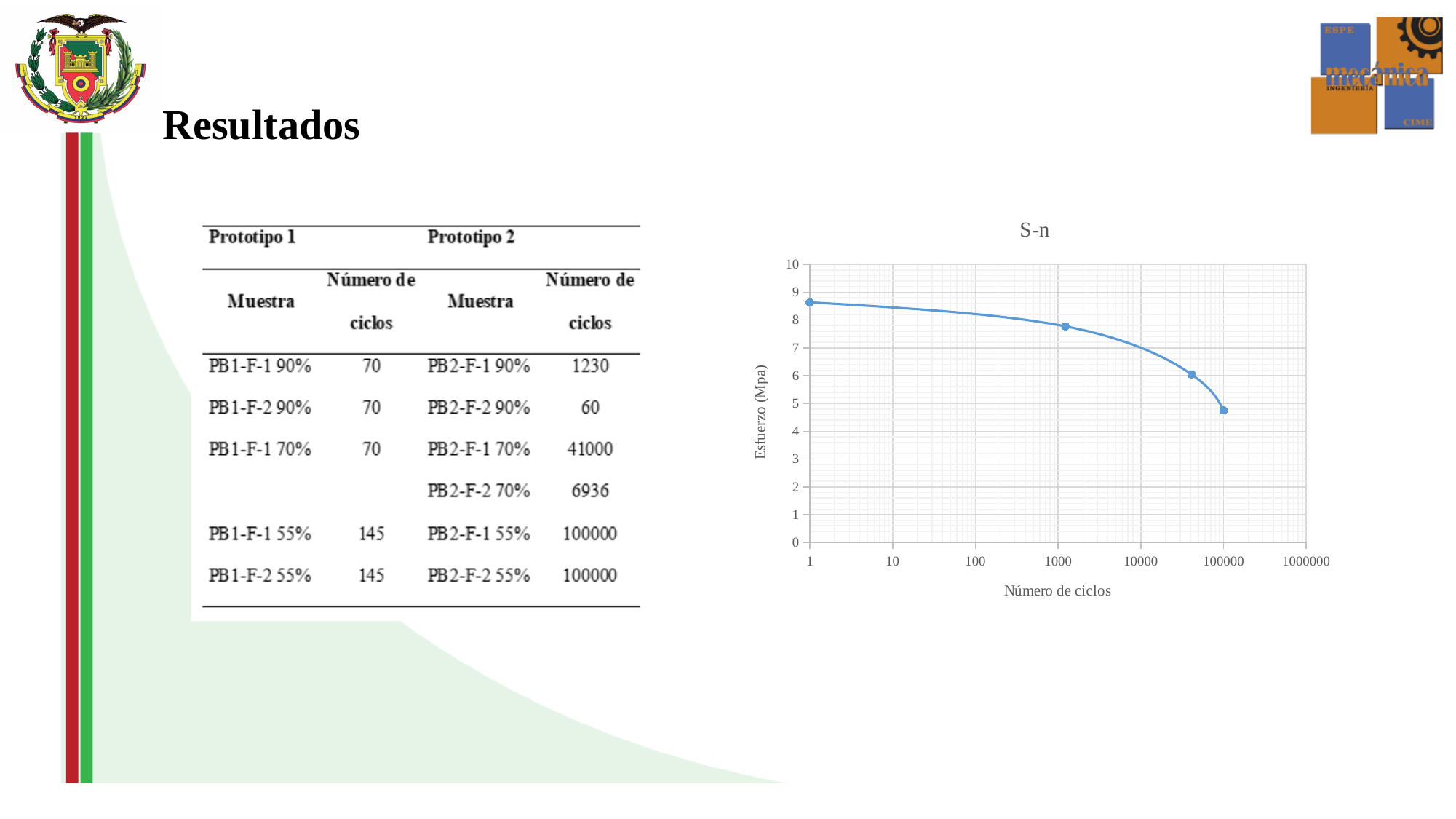
On the S-n chart, which has the higher stress: the point at 1 cycle or the point at 100000 cycles? the point at 1 cycle On the S-n chart, is the stress at the second data point (around 1000 cycles) greater or less than 7 Mpa? greater On the S-n chart, is the stress at 1 cycle greater or less than 8 Mpa? greater On the S-n chart, is the stress at the third data point (between 10000 and 100000 cycles) greater or less than 7 Mpa? less What is the title of the chart on the slide? S-n What is the label of the y axis of the S-n chart? Esfuerzo (Mpa) On the S-n chart, at which number of cycles on the x axis is the stress lowest? 100000 How many data points are plotted on the S-n chart? 4 On the S-n chart, at which number of cycles on the x axis is the stress highest? 1 What kind of chart is the S-n chart? line chart On the S-n chart, does the stress (Esfuerzo) rise or fall as the number of cycles increases? fall